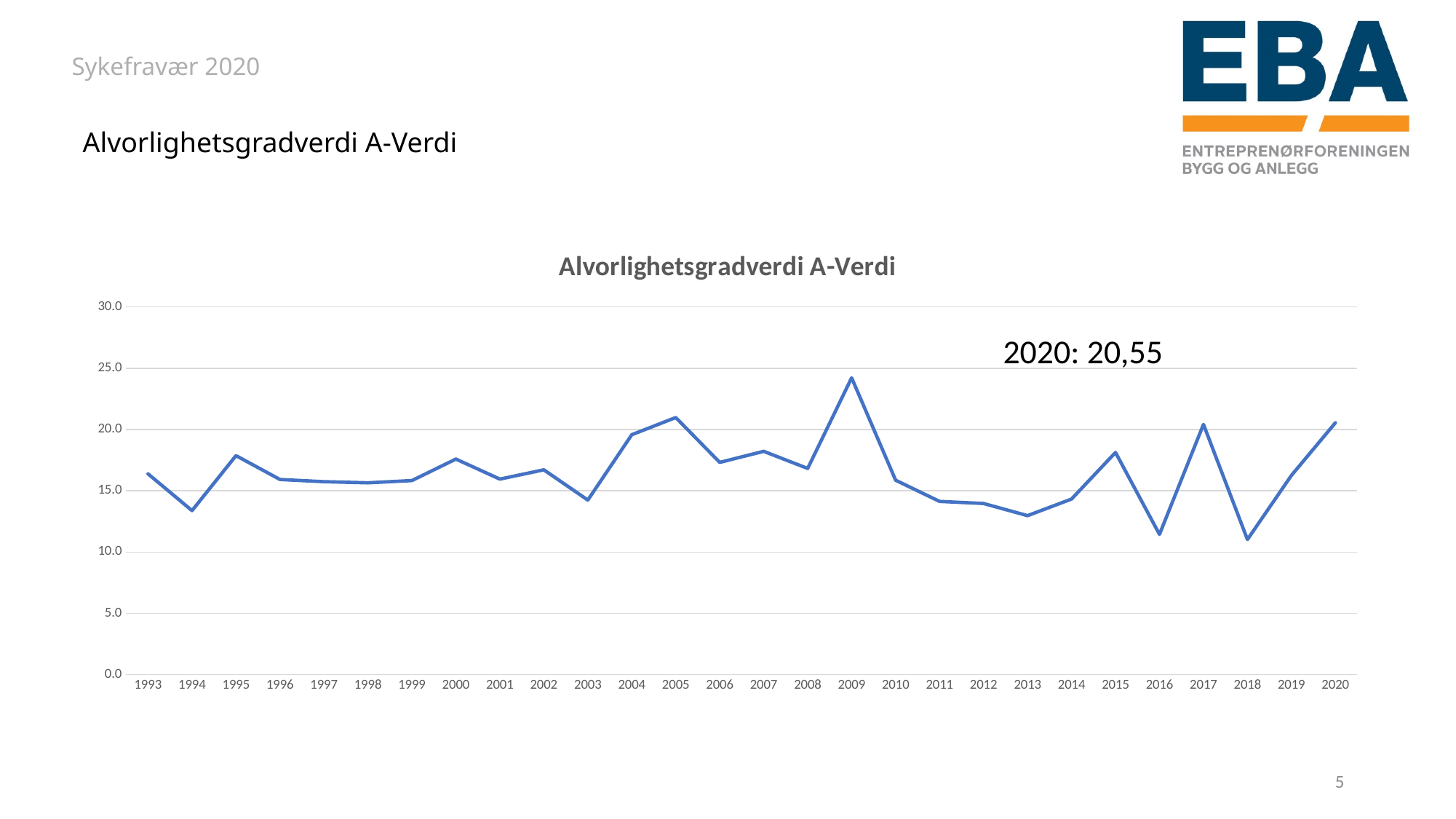
How many years are plotted along the x axis? 28 Which is larger, the value for 2017 or the value for 2018? 2017 Is the value for 2009 greater or less than 20? greater Which year has the highest value in the chart? 2009 What is the value for 2020 in the chart? 20,55 Which is larger, the value for 2009 or the value for 2020? 2009 Is the value for 2018 greater or less than 15? less Is the value for 1994 greater or less than 15? less What is the title of the chart? Alvorlighetsgradverdi A-Verdi Do the values rise or fall from 2018 to 2020? rise What kind of chart is shown on the slide? line chart